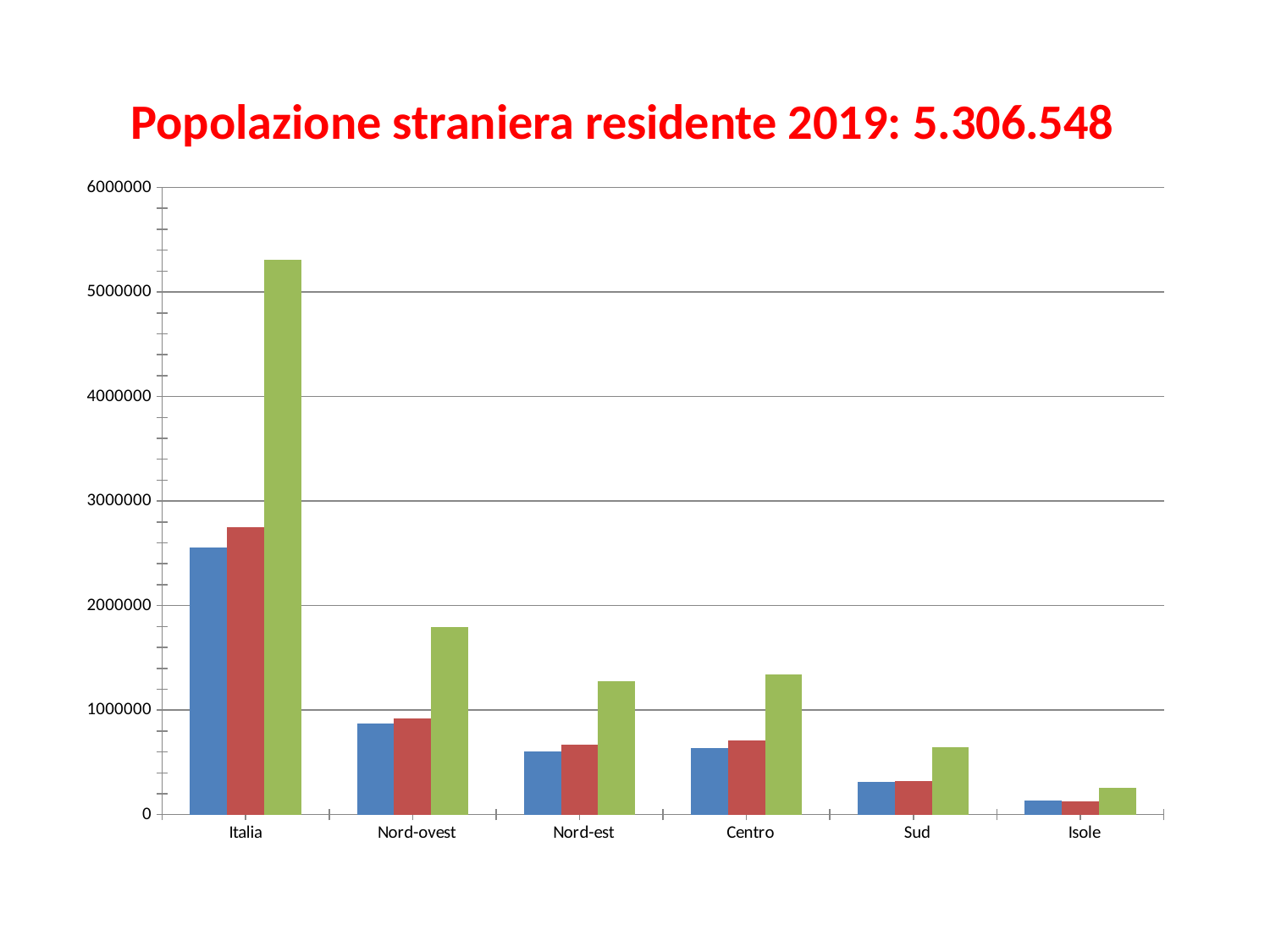
Which has the taller green bar, Nord-ovest or Nord-est? Nord-ovest What kind of chart is shown on the slide? bar chart How many bars are plotted for each category? 3 Is the green bar for Italia greater or less than 5000000? greater Is the green bar for Nord-ovest greater or less than 2000000? less How many categories are shown on the x axis? 6 Which category has the shortest green bar? Isole Is the green bar for Sud greater or less than 1000000? less Do the green bars rise or fall going from Centro to Isole? fall What is the title of the chart? Popolazione straniera residente 2019: 5.306.548 Which category has the tallest green bar? Italia